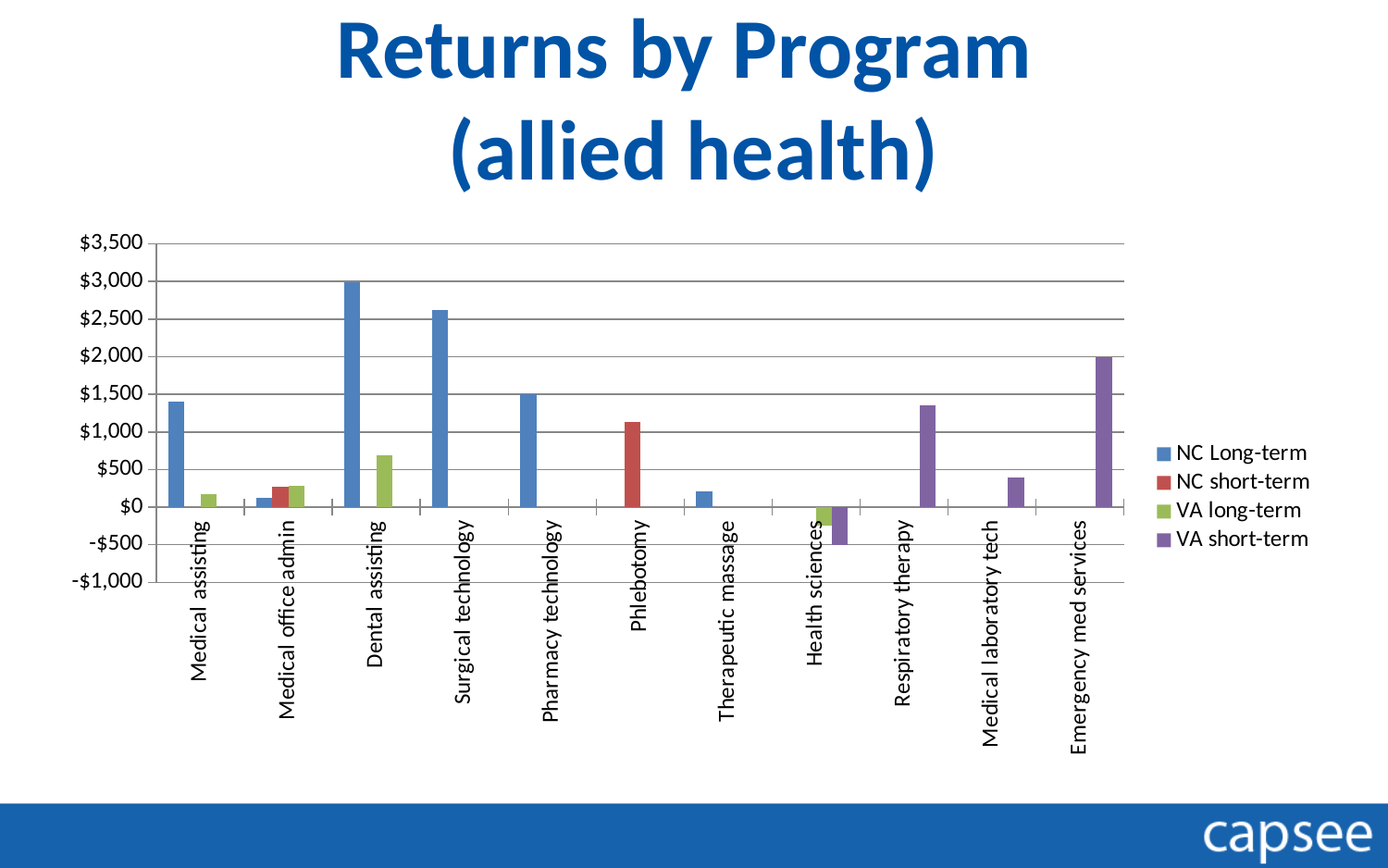
How many programs are shown along the x axis? 11 What is the title of the chart? Returns by Program (allied health) Which program has the highest VA short-term return? Emergency med services Is the NC Long-term value for Dental assisting greater or less than $2,500? greater What kind of chart is shown on the slide? bar chart Is the NC short-term value for Phlebotomy greater or less than $1,000? greater Is the VA short-term value for Health sciences greater or less than $0? less Which has the larger NC Long-term return, Surgical technology or Pharmacy technology? Surgical technology Which program has the highest NC Long-term return? Dental assisting How many series does the legend list? 4 What colour represents the VA short-term series in the legend? purple